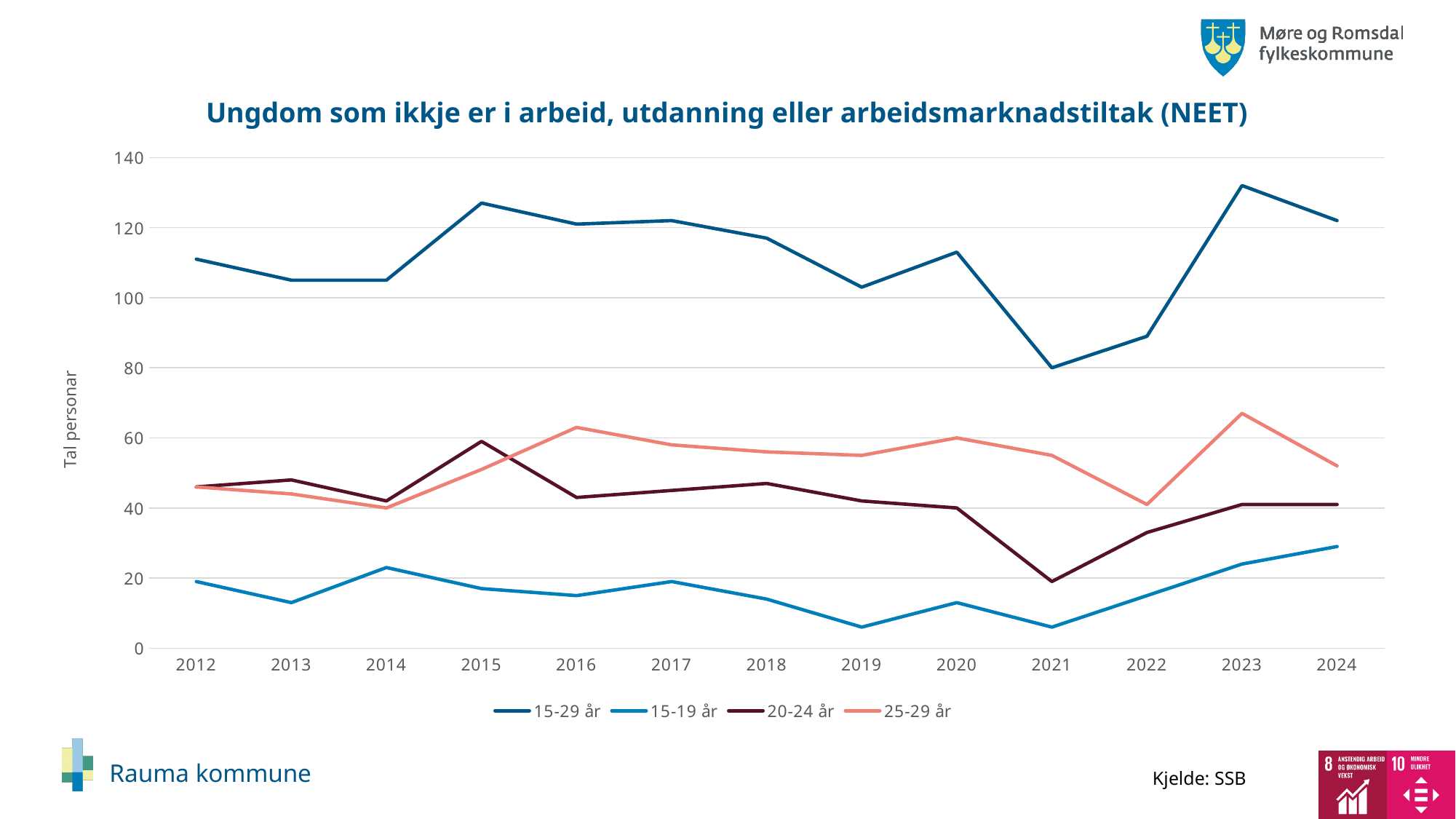
Is the value for 15-19 år in 2019 greater or less than 20? less Is the value for 15-29 år in 2021 greater or less than 100? less What kind of chart is shown on the slide? line chart Is the value for 15-29 år in 2023 greater or less than 120? greater How many years are shown on the x axis? 13 Does the 15-29 år series rise or fall from 2021 to 2023? rise What is the label on the y axis of the chart? Tal personar In which year does the 15-29 år series reach its highest value? 2023 In 2016, which series has the larger value: 25-29 år or 20-24 år? 25-29 år How many series does the legend list? 4 In which year does the 20-24 år series reach its lowest value? 2021 In which year does the 15-29 år series reach its lowest value? 2021